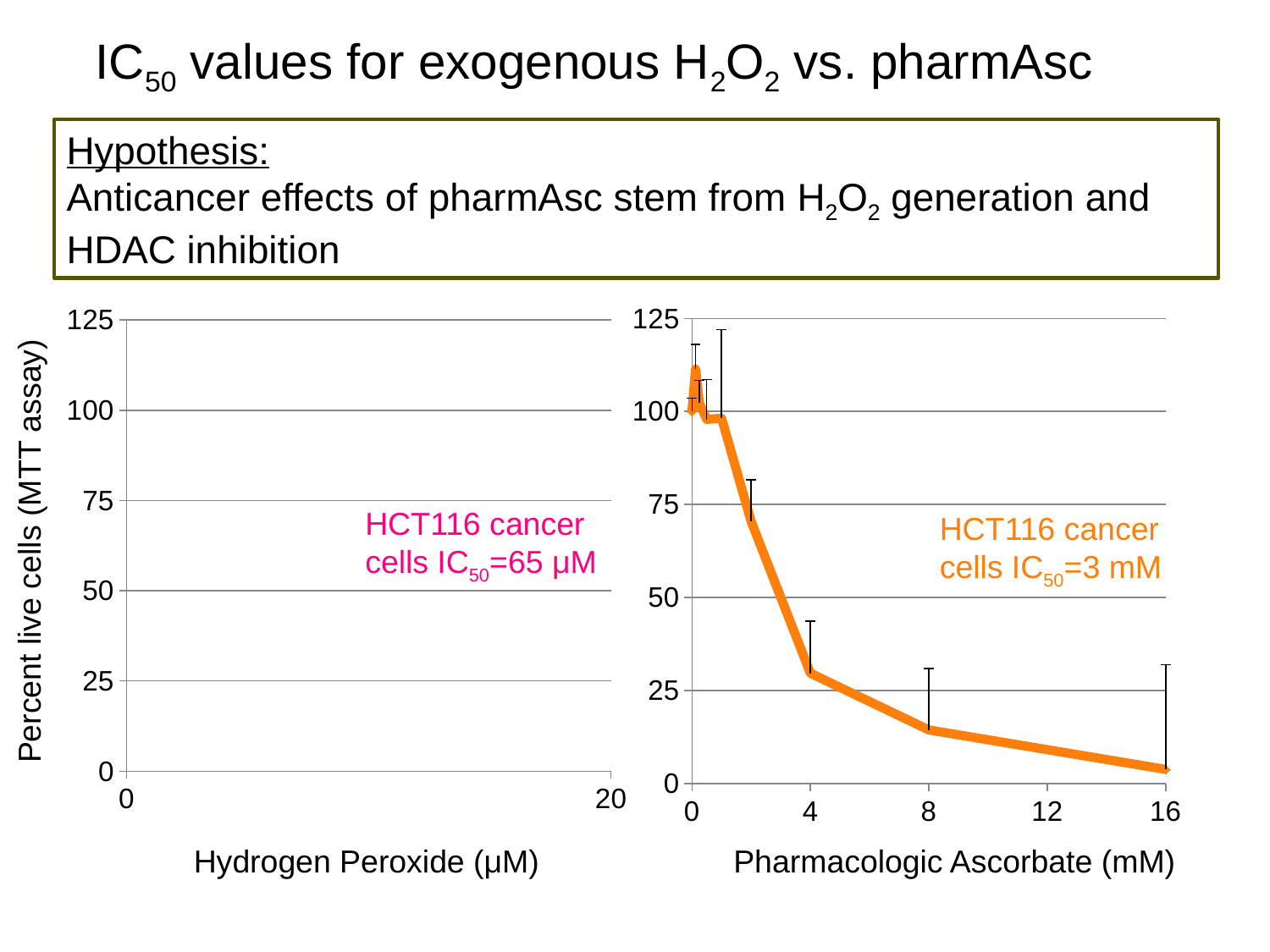
What kind of chart is the right-hand chart (Pharmacologic Ascorbate)? line chart On the right-hand chart (Pharmacologic Ascorbate), is the percent live cells at 8 mM greater or less than 25? less On the right-hand chart (Pharmacologic Ascorbate), is the percent live cells at 2 mM greater or less than 50? greater On the right-hand chart (Pharmacologic Ascorbate), do the values rise or fall as the concentration increases along the x axis? fall On the right-hand chart (Pharmacologic Ascorbate), which has the higher percent live cells: 4 mM or 16 mM? 4 mM What IC50 value is annotated on the right-hand chart (Pharmacologic Ascorbate) for HCT116 cancer cells? 3 mM What is the x-axis label of the left-hand chart? Hydrogen Peroxide (µM) On the right-hand chart (Pharmacologic Ascorbate), is the percent live cells at 16 mM greater or less than 25? less On the right-hand chart (Pharmacologic Ascorbate), at which plotted concentration is the percent live cells lowest? 16 mM